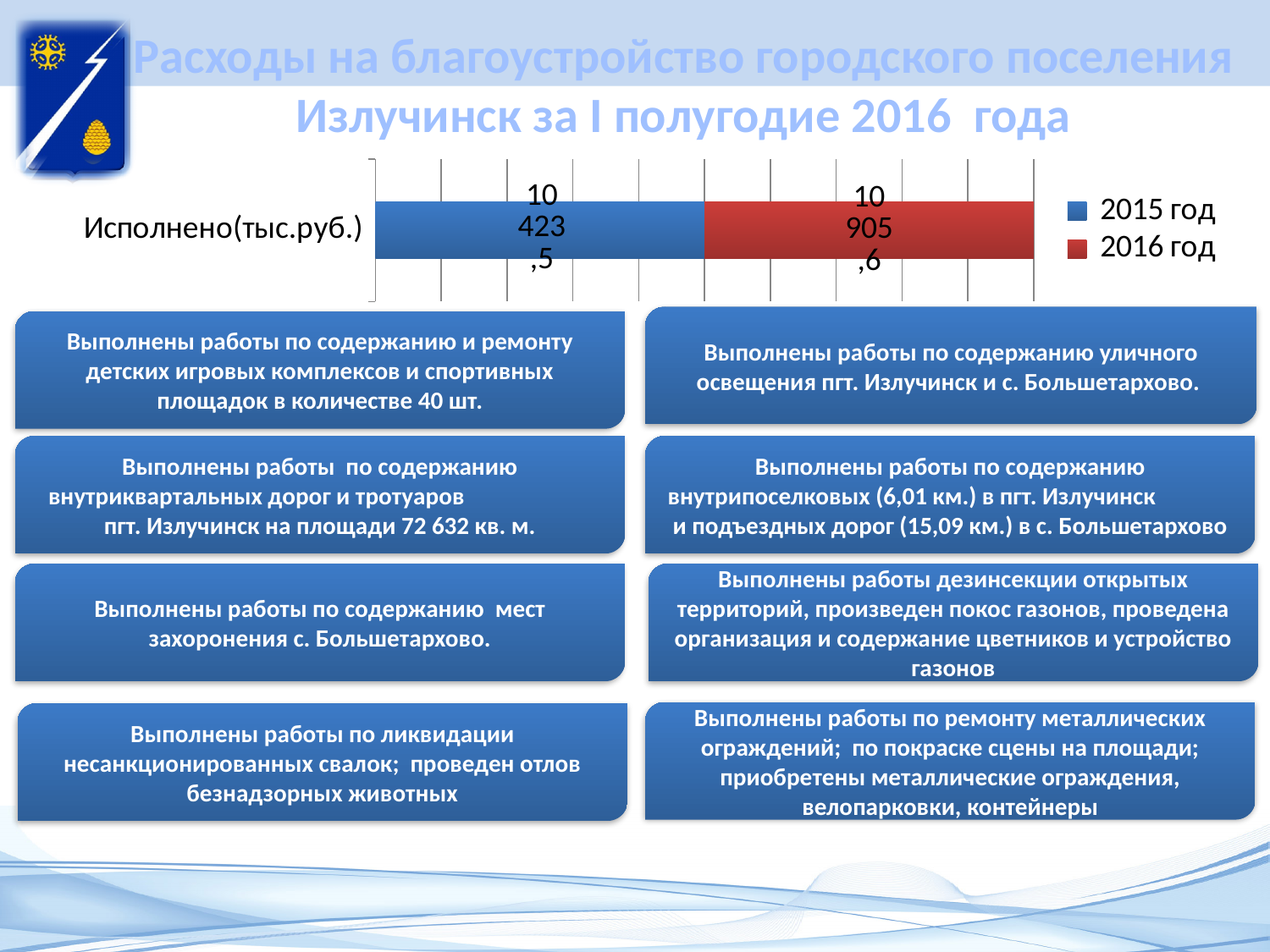
What is the value for 2015 год in the chart? 10 423,5 Which series has the lowest value in the chart? 2015 год What is the difference between the 2016 год and 2015 год values in the chart? 482,1 Which colour represents 2016 год in the chart? red How many series does the chart legend list? 2 What is the total of the 2015 год and 2016 год values in the chart? 21 329,1 What is the category label shown on the chart's axis? Исполнено(тыс.руб.) What kind of chart is shown on the slide? bar chart Which year has the higher value in the chart, 2015 год or 2016 год? 2016 год What is the value for 2016 год in the chart? 10 905,6 How many categories are shown on the chart's axis? 1 Which series has the highest value in the chart? 2016 год